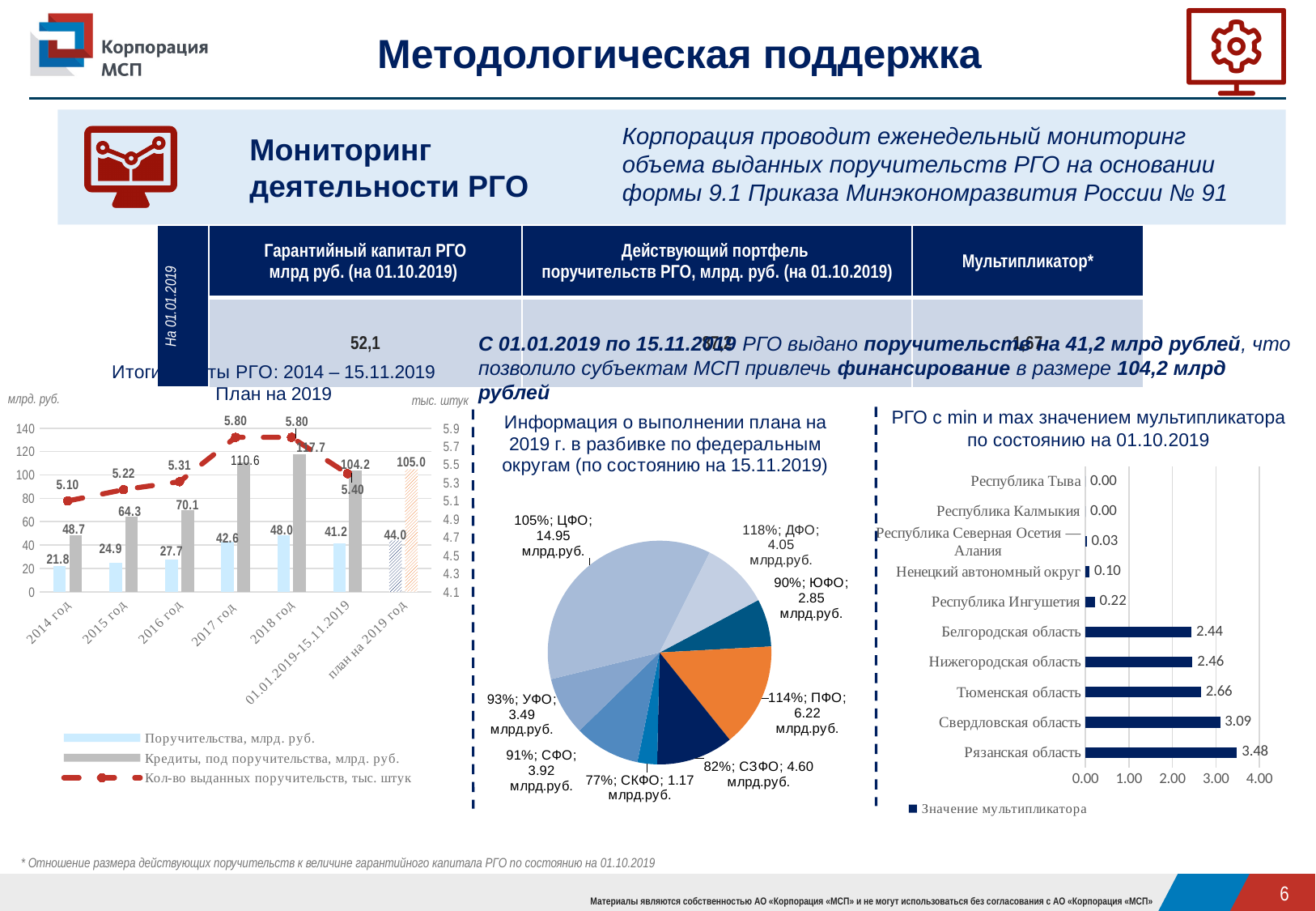
In the chart 'РГО с min и max значением мультипликатора по состоянию на 01.10.2019', what is the value for Рязанская область? 3.48 In the chart 'РГО с min и max значением мультипликатора по состоянию на 01.10.2019', how many regions are shown? 10 In the pie chart 'Информация о выполнении плана на 2019 г. в разбивке по федеральным округам', which federal district has the smallest slice? СКФО In the chart 'Итоги работы РГО: 2014 – 15.11.2019', what is the value of 'Кредиты, под поручительства, млрд. руб.' for 2016 год? 70.1 In the chart 'РГО с min и max значением мультипликатора по состоянию на 01.10.2019', what is the value for Ненецкий автономный округ? 0.10 In the chart 'РГО с min и max значением мультипликатора по состоянию на 01.10.2019', what is the difference between Свердловская область and Белгородская область? 0.65 In the pie chart 'Информация о выполнении плана на 2019 г. в разбивке по федеральным округам', how many federal districts are shown? 8 In the chart 'РГО с min и max значением мультипликатора по состоянию на 01.10.2019', which region has the highest multiplier value? Рязанская область In the pie chart 'Информация о выполнении плана на 2019 г. в разбивке по федеральным округам', what value is shown for ЦФО? 14.95 млрд.руб. In the pie chart 'Информация о выполнении плана на 2019 г. в разбивке по федеральным округам', what plan completion percentage is shown for ДФО? 118% In the chart 'Итоги работы РГО: 2014 – 15.11.2019', how many series does the legend list? 3 In the chart 'Итоги работы РГО: 2014 – 15.11.2019', what is the value of 'Поручительства, млрд. руб.' for 2017 год? 42.6